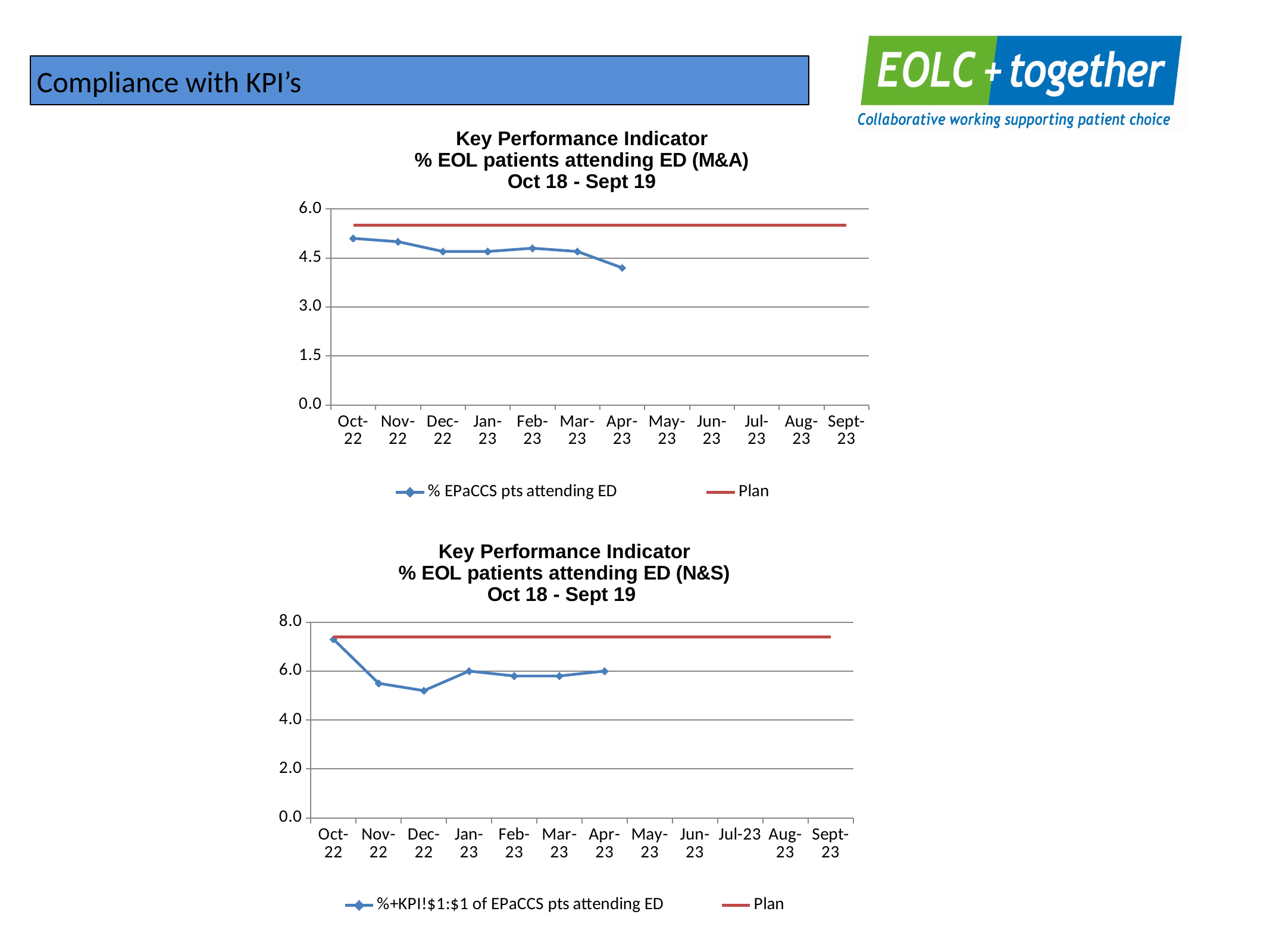
In the bottom chart (N&S), which month has the highest plotted value? Oct-22 How many month categories are shown on the x axis of the top chart (M&A)? 12 How many series does the legend of the top chart (M&A) list? 2 In the top chart (M&A), does the % EPaCCS pts attending ED line rise or fall overall from Oct-22 to Apr-23? fall In the top chart (M&A), is the value for Apr-23 greater or less than 4.5? less In the bottom chart (N&S), which is larger, the value for Oct-22 or the value for Nov-22? Oct-22 In the top chart (M&A), is the value for Oct-22 greater or less than 4.5? greater In the top chart (M&A), which month has the lowest plotted value for % EPaCCS pts attending ED? Apr-23 What kind of chart is the top chart, '% EOL patients attending ED (M&A)'? line chart In the bottom chart (N&S), which month has the lowest plotted value? Dec-22 What is the name of the red series in the legend of the bottom chart (N&S)? Plan In the bottom chart (N&S), is the value for Dec-22 greater or less than 6.0? less